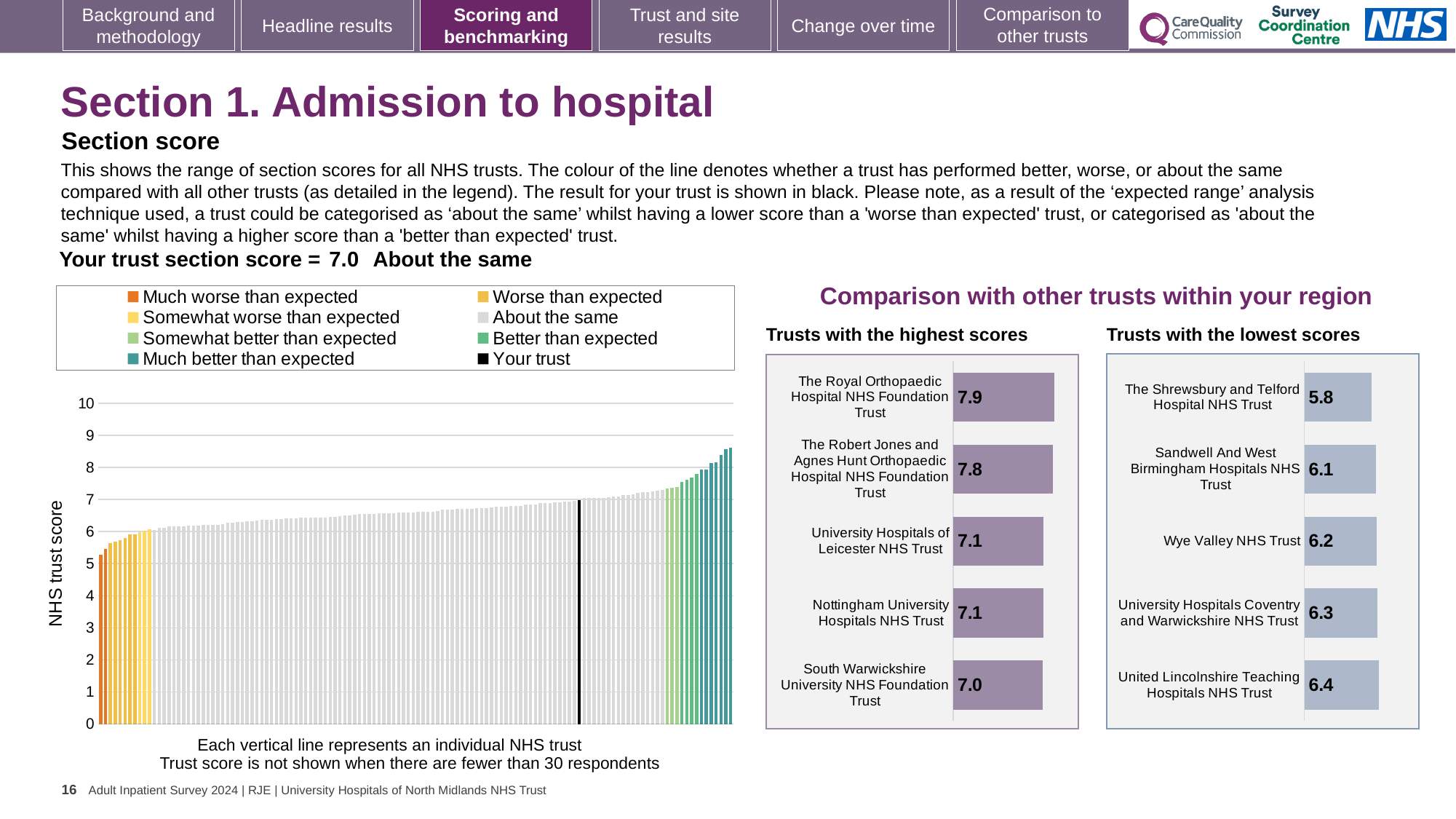
In the 'Trusts with the highest scores' chart, what is the score for The Royal Orthopaedic Hospital NHS Foundation Trust? 7.9 In the 'Trusts with the lowest scores' chart, what is the difference between the scores of United Lincolnshire Teaching Hospitals NHS Trust and The Shrewsbury and Telford Hospital NHS Trust? 0.6 In the 'Trusts with the highest scores' chart, which trust has the lowest score shown? South Warwickshire University NHS Foundation Trust In the main NHS trust score chart on the left, what is the section score for your trust (the black line)? 7.0 In the 'Trusts with the highest scores' chart, what is the difference between the scores of The Royal Orthopaedic Hospital NHS Foundation Trust and South Warwickshire University NHS Foundation Trust? 0.9 In the 'Trusts with the lowest scores' chart, which has the larger score: Sandwell And West Birmingham Hospitals NHS Trust or University Hospitals Coventry and Warwickshire NHS Trust? University Hospitals Coventry and Warwickshire NHS Trust In the 'Trusts with the lowest scores' chart, what is the score for Wye Valley NHS Trust? 6.2 In the main NHS trust score chart on the left, is the value of the highest bar greater or less than 8? greater In the 'Trusts with the lowest scores' chart, which trust has the highest score? United Lincolnshire Teaching Hospitals NHS Trust How many entries does the legend of the main NHS trust score chart on the left list? 8 In the 'Trusts with the highest scores' chart, how many trusts are listed? 5 In the 'Trusts with the lowest scores' chart, which trust has the lowest score? The Shrewsbury and Telford Hospital NHS Trust